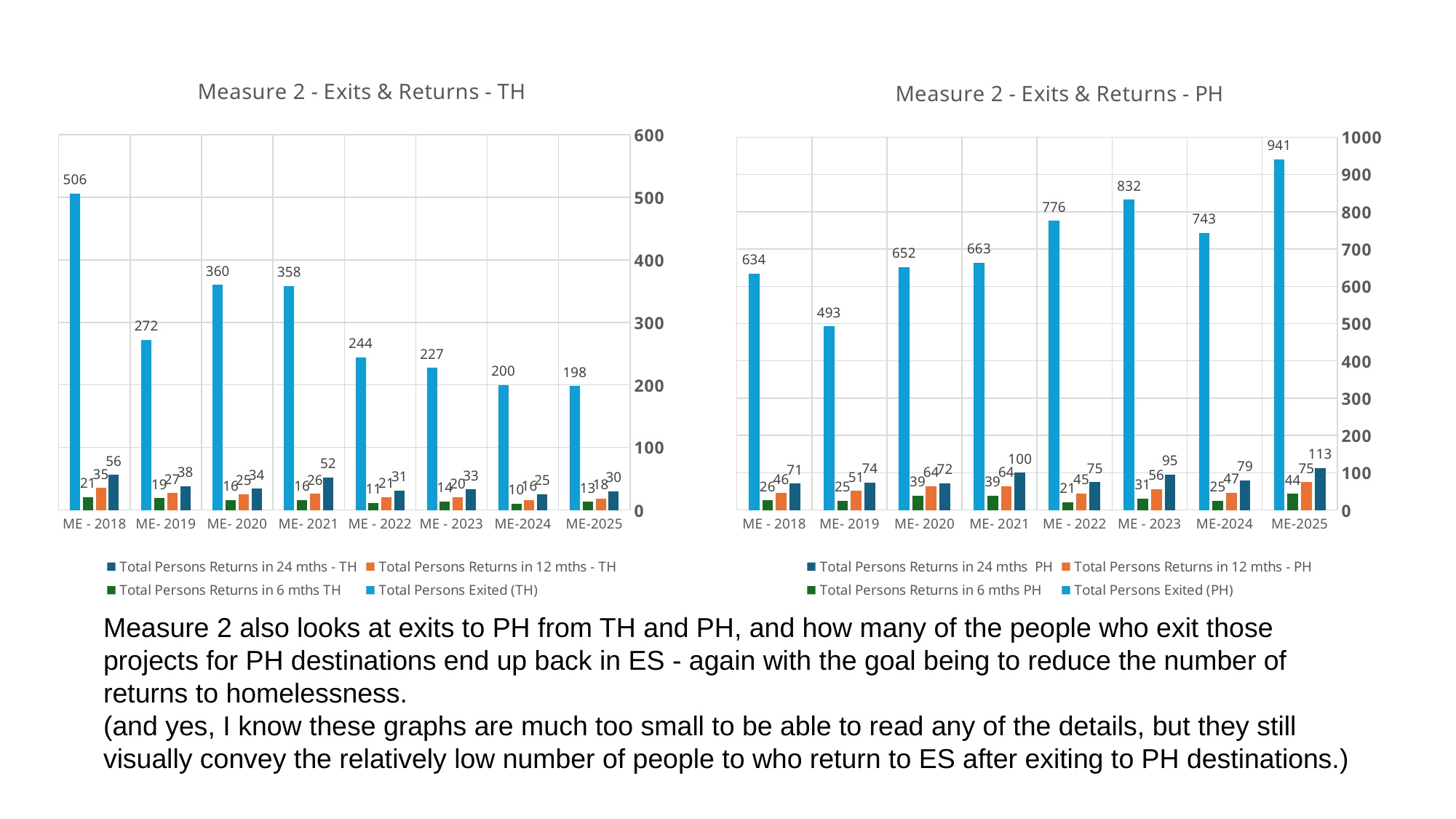
How many categories are shown on the x axis of the 'Measure 2 - Exits & Returns - TH' chart? 8 In the 'Measure 2 - Exits & Returns - TH' chart, what is the value of Total Persons Exited (TH) for ME - 2018? 506 In the 'Measure 2 - Exits & Returns - TH' chart, what is the difference between Total Persons Exited (TH) for ME - 2018 and ME - 2019? 234 In the 'Measure 2 - Exits & Returns - PH' chart, what is the value of Total Persons Exited (PH) for ME-2025? 941 What kind of chart is the 'Measure 2 - Exits & Returns - TH' chart? Bar chart In the 'Measure 2 - Exits & Returns - PH' chart, is the value of Total Persons Exited (PH) for ME - 2019 greater or less than 500? less In the 'Measure 2 - Exits & Returns - PH' chart, which is larger: Total Persons Exited (PH) for ME - 2023 or for ME-2024? ME - 2023 In the 'Measure 2 - Exits & Returns - TH' chart, what is the value of Total Persons Returns in 6 mths TH for ME - 2022? 11 In the 'Measure 2 - Exits & Returns - TH' chart, which category has the lowest Total Persons Exited (TH)? ME-2025 In the 'Measure 2 - Exits & Returns - PH' chart, which category has the highest Total Persons Exited (PH)? ME-2025 In the 'Measure 2 - Exits & Returns - PH' chart, what is the value of Total Persons Returns in 24 mths PH for ME - 2021? 100 How many series does the legend of the 'Measure 2 - Exits & Returns - PH' chart list? 4